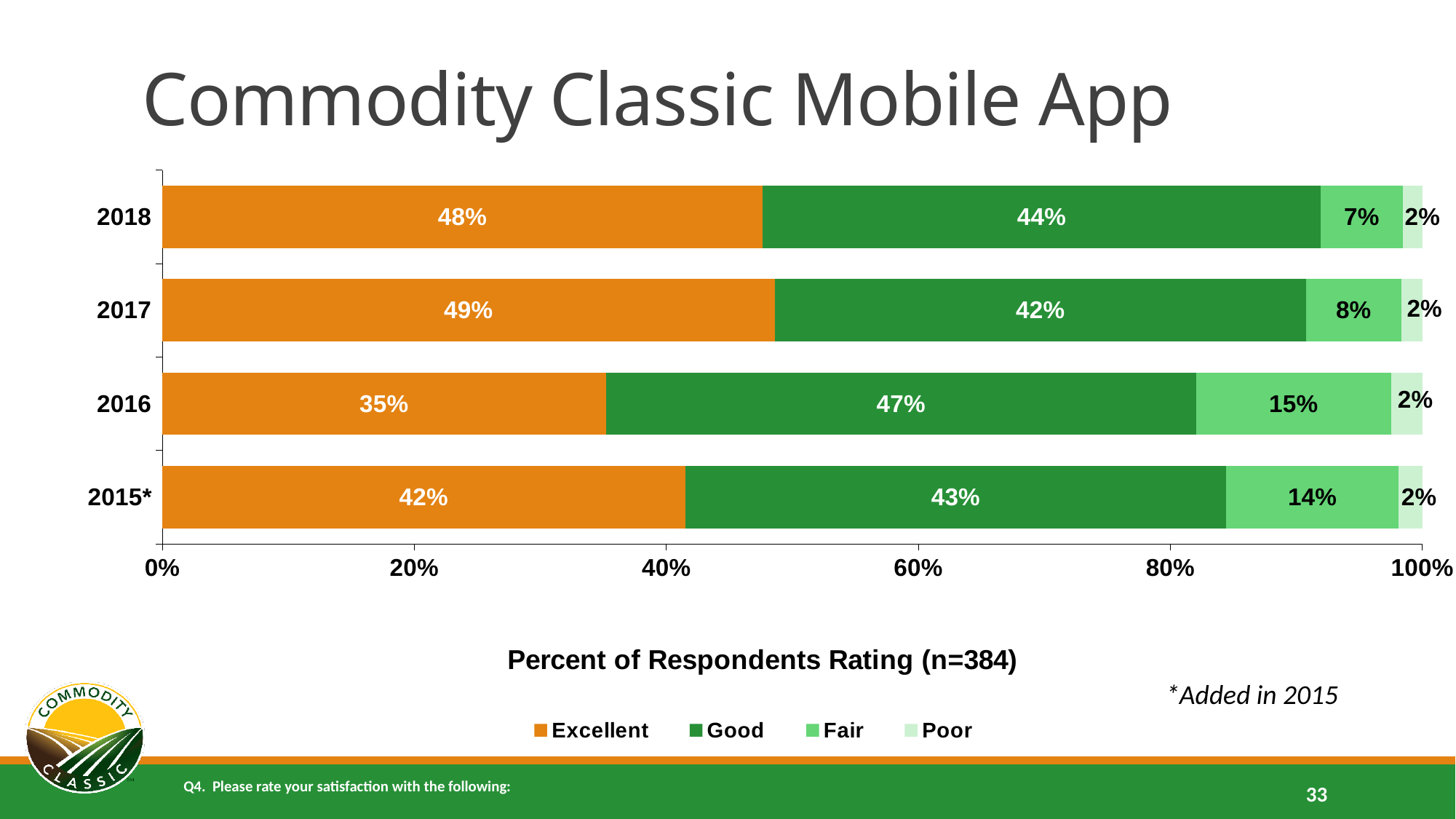
Which year has the lowest Excellent rating? 2016 How many years are shown on the chart? 4 What percentage of respondents rated the mobile app Good in 2015*? 43% What is the combined Excellent and Good rating for 2018? 92% How many series does the legend list? 4 What percentage of respondents rated the mobile app Fair in 2016? 15% Which is larger, the Fair rating in 2015* or the Fair rating in 2018? 2015* What kind of chart is shown on the slide? Stacked bar chart What is the sample size shown in the chart's axis title? n=384 What is the difference between the Good rating in 2016 and the Good rating in 2017? 5% Which year has the highest Excellent rating? 2017 What percentage of respondents rated the mobile app Excellent in 2018? 48%